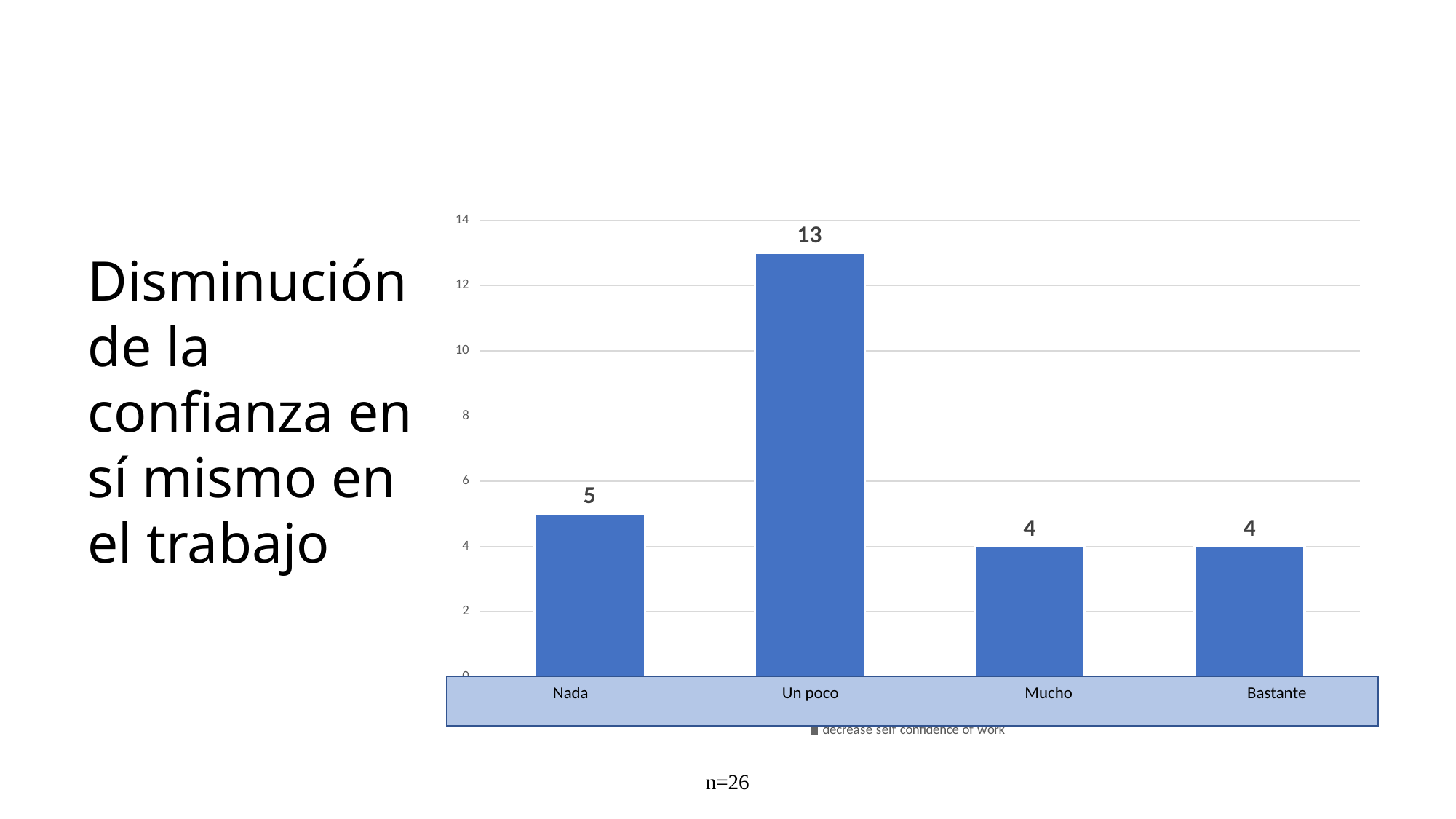
How many series does the legend list? 1 What is the value for Mucho? 4 What kind of chart is shown on the slide? bar chart Which category has the highest value? Un poco What is the value for Nada? 5 What is the legend entry for the series? decrease self confidence of work What is the difference between the values for Un poco and Nada? 8 What is the total of the values for Nada, Un poco, Mucho and Bastante? 26 Which is larger, the value for Nada or the value for Bastante? Nada How many categories are shown on the x axis? 4 Is the value for Un poco greater or less than 12? greater What is the value for Un poco? 13